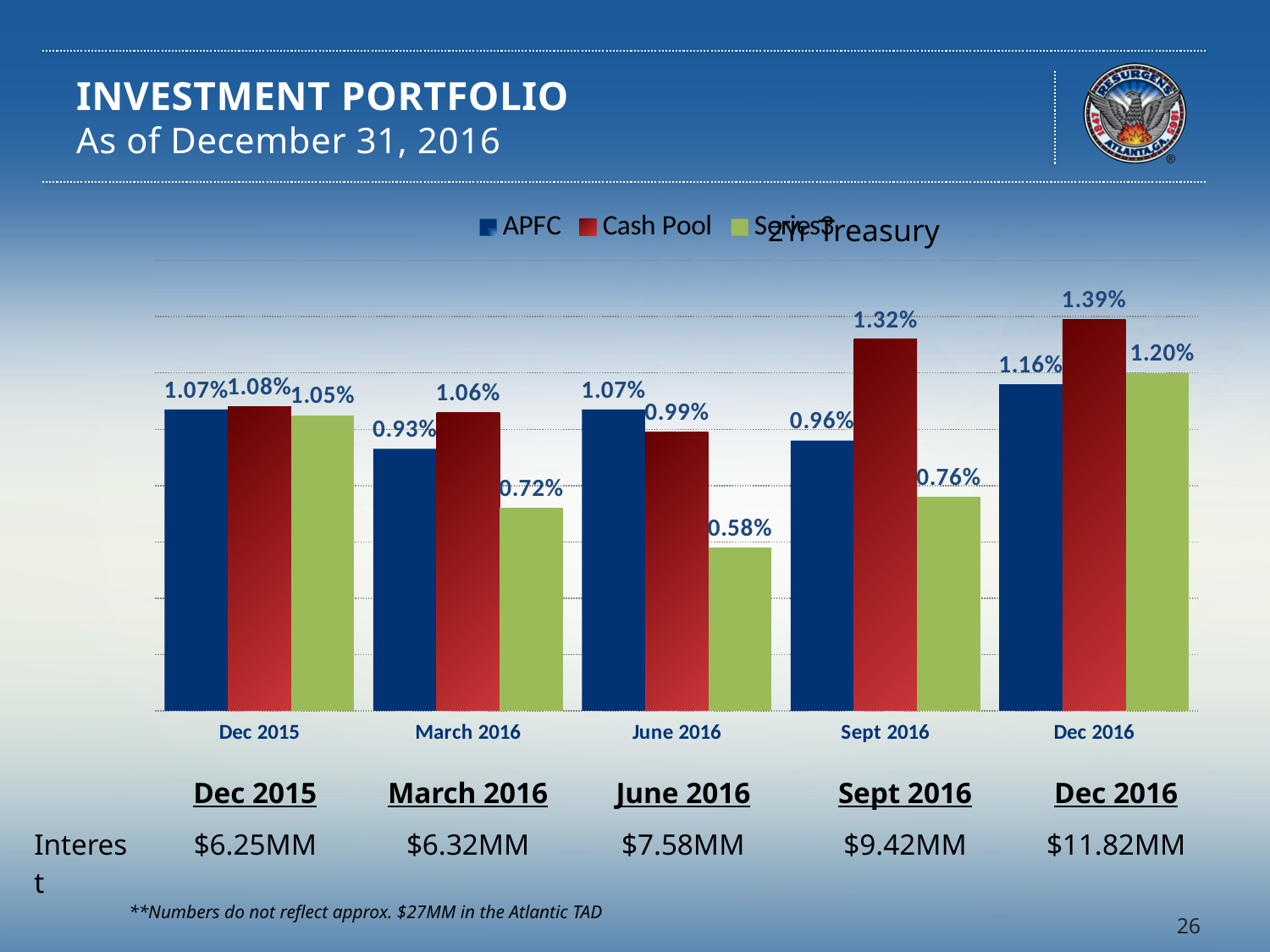
What kind of chart is shown on the slide? Bar chart What is the difference between the Cash Pool and APFC values for Dec 2016? 0.23% What is the Cash Pool value for Sept 2016? 1.32% How many series does the chart's legend list? 3 Does the Cash Pool value rise or fall from Sept 2016 to Dec 2016? Rise How many periods are shown on the x axis of the chart? 5 In which period is the APFC value lowest? March 2016 What is the value of the green bar for June 2016? 0.58% In which period is the Cash Pool value highest? Dec 2016 What is the APFC value for March 2016? 0.93% For June 2016, which is larger: APFC or Cash Pool? APFC What colour are the Cash Pool bars in the chart? Red